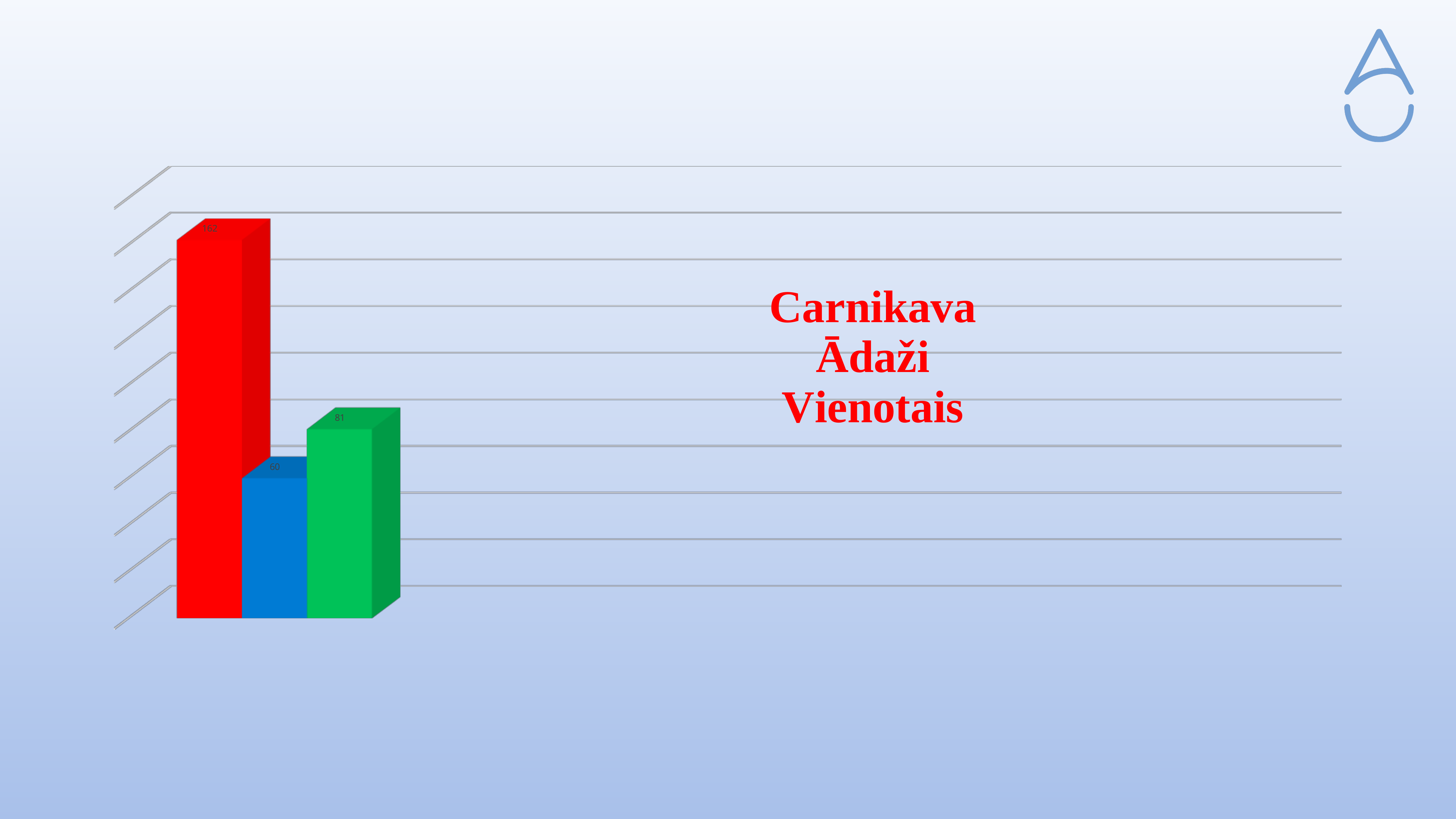
Which is larger, the value of the green bar or the value of the blue bar? the green bar Which bar has the highest value? the red bar What is the difference between the red bar's value and the green bar's value? 81 What value is printed on the green bar? 81 Which bar has the lowest value? the blue bar What value is printed on the red bar? 162 What is the total of the three bar values? 303 What value is printed on the blue bar? 60 What colour is the tallest bar in the chart? red How many bars are plotted in the chart? 3 What kind of chart is shown on the slide? bar chart What is the difference between the green bar's value and the blue bar's value? 21